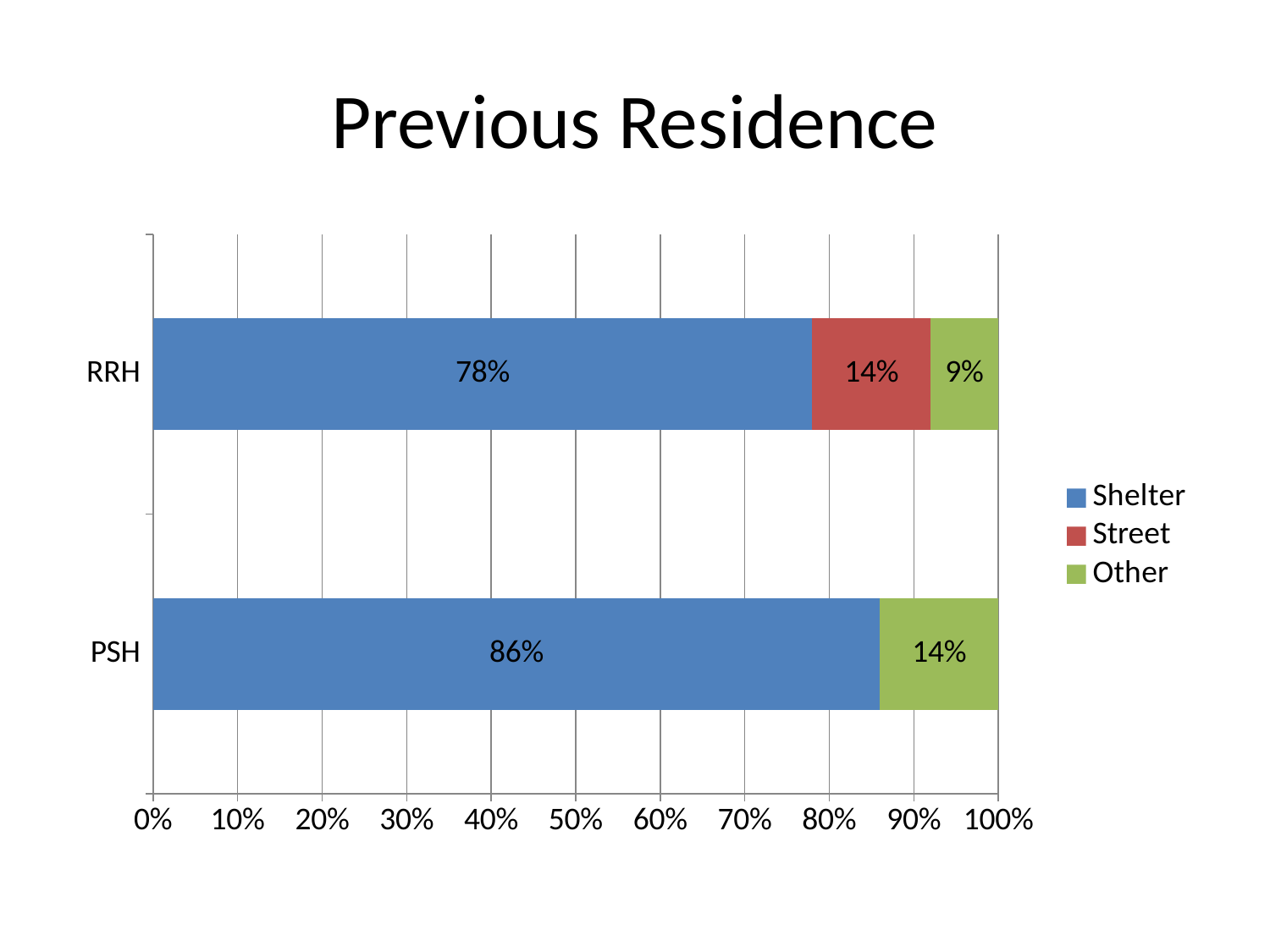
What is the Other value for PSH? 14% What is the Street value for RRH? 14% Which category has the higher Shelter value, RRH or PSH? PSH What is the difference in percentage points between the Street value and the Other value for RRH? 5 percentage points What is the difference in percentage points between the Shelter value for PSH and the Shelter value for RRH? 8 percentage points What is the title of the chart? Previous Residence What is the Other value for RRH? 9% How many series does the legend list? 3 What kind of chart is shown on the slide? Stacked bar chart What is the Shelter value for RRH? 78% What is the Shelter value for PSH? 86% How many categories are shown on the vertical axis? 2